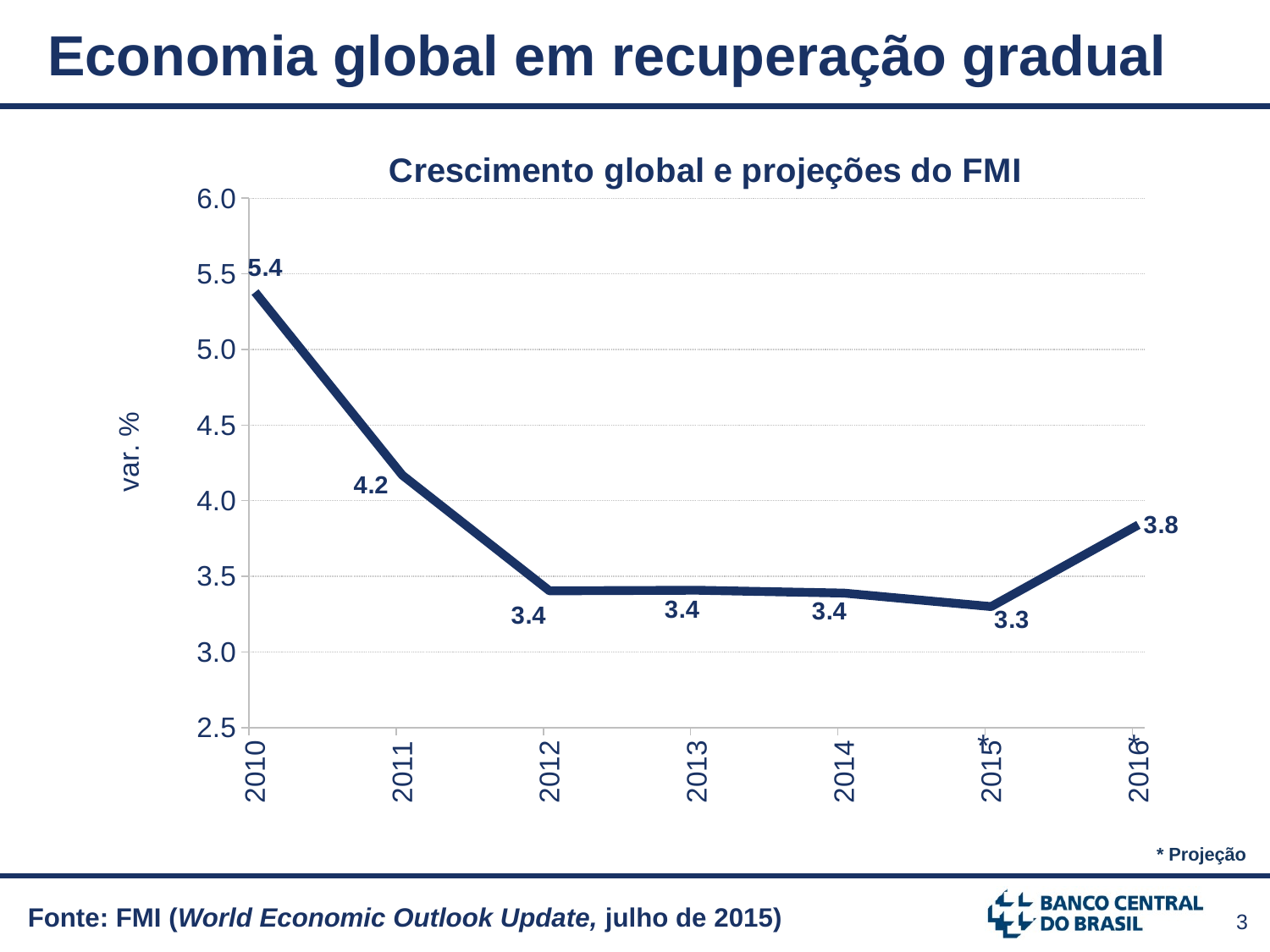
Which is larger, the value for 2011 or the value for 2016*? 2011 How many years are plotted on the chart? 7 Which year has the highest value? 2010 What is the projected value for 2016*? 3.8 Which year has the lowest value? 2015* What is the difference between the values for 2016* and 2015*? 0.5 What is the title of the chart? Crescimento global e projeções do FMI What is the value for 2010? 5.4 What kind of chart is shown? line chart What is the value for 2011? 4.2 What is the value for 2015*? 3.3 What is the difference between the values for 2010 and 2011? 1.2